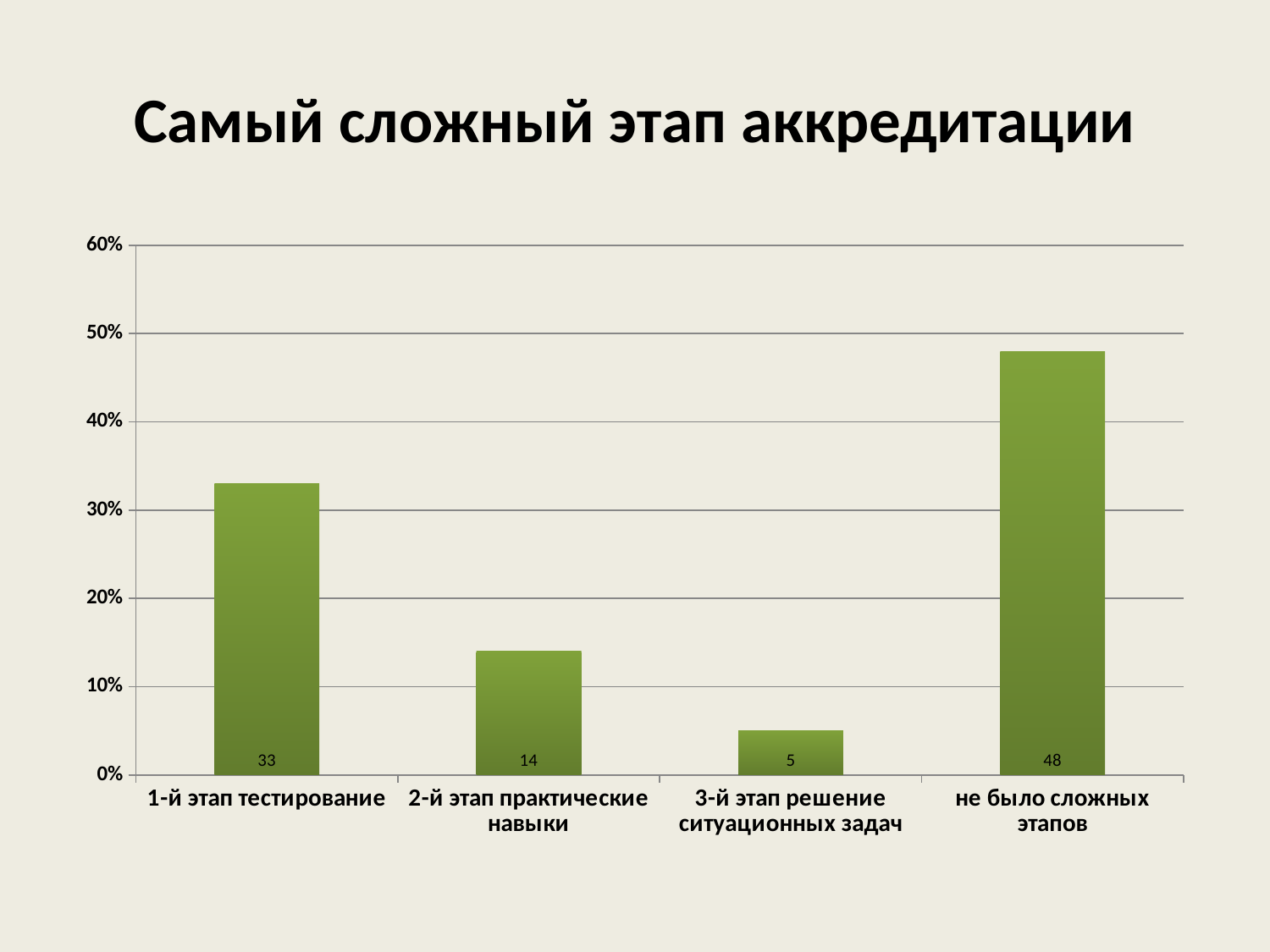
Is the value for «не было сложных этапов» greater or less than 40%? greater What is the value shown for «3-й этап решение ситуационных задач»? 5 Which is larger: the value for «1-й этап тестирование» or for «2-й этап практические навыки»? 1-й этап тестирование What kind of chart is shown on the slide? bar chart What is the difference between the values for «не было сложных этапов» and «1-й этап тестирование»? 15 What is the value shown for «2-й этап практические навыки»? 14 What is the title of the slide? Самый сложный этап аккредитации What is the value shown for «не было сложных этапов»? 48 Which category has the lowest value? 3-й этап решение ситуационных задач Which category has the highest value? не было сложных этапов How many categories are shown on the chart? 4 What is the value shown for «1-й этап тестирование»? 33